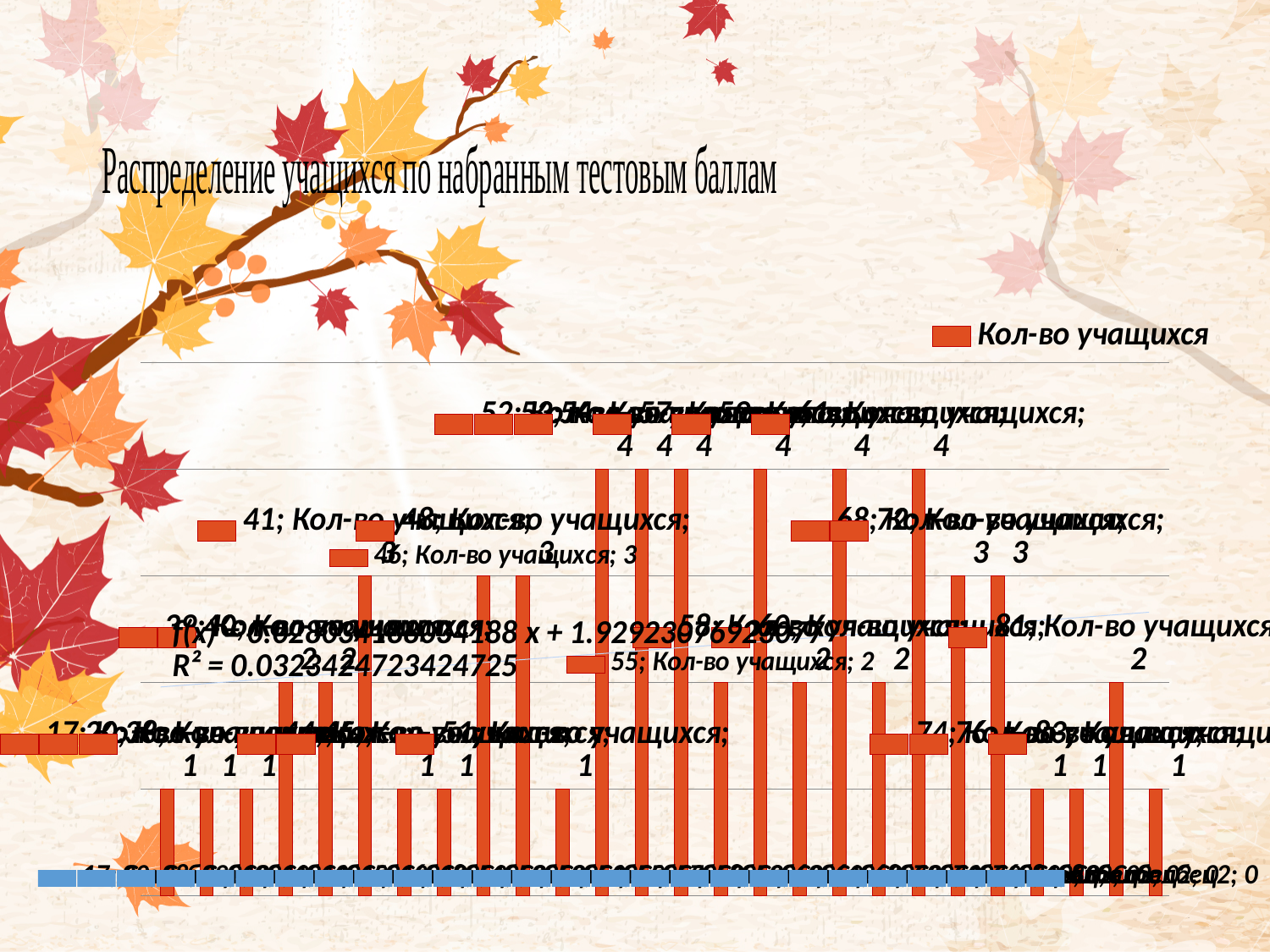
What is the difference between the number of students for score 41 and for score 55? 1 What is the number of students (Кол-во учащихся) for a score of 41? 3 What is the number of students for a score of 55? 2 What is the number of students for a score of 81? 2 What is the highest number of students shown for any single score in the chart? 4 What kind of chart is shown on the slide? bar chart What is the number of students for a score of 68? 3 Which score has more students, 41 or 55? 41 What is the number of students for a score of 46? 3 How many series does the chart legend list? 1 What is the title of the chart? Распределение учащихся по набранным тестовым баллам What is the name of the series shown in the chart legend? Кол-во учащихся